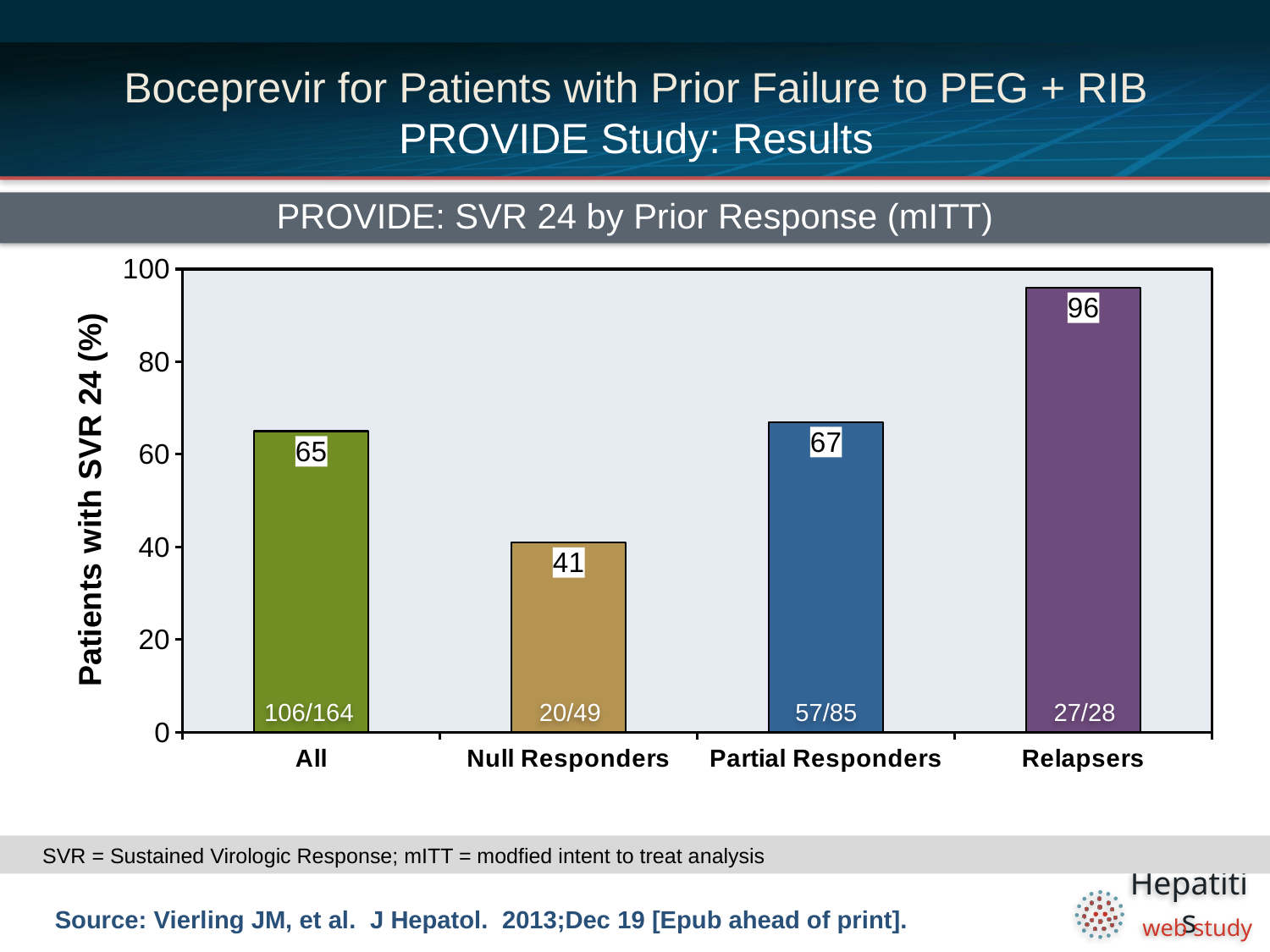
Which category has the highest SVR 24 rate? Relapsers How many categories are shown on the x axis? 4 What is the difference in SVR 24 rate between Relapsers and Null Responders? 55 What is the SVR 24 rate for Null Responders? 41 What is the label of the y axis? Patients with SVR 24 (%) Which has a higher SVR 24 rate, Partial Responders or All? Partial Responders What fraction of patients is shown inside the bar for the All group? 106/164 Which category has the lowest SVR 24 rate? Null Responders What kind of chart is shown on the slide? Bar chart What is the SVR 24 rate for Relapsers? 96 What is the SVR 24 rate for Partial Responders? 67 What is the title of the chart? PROVIDE: SVR 24 by Prior Response (mITT)